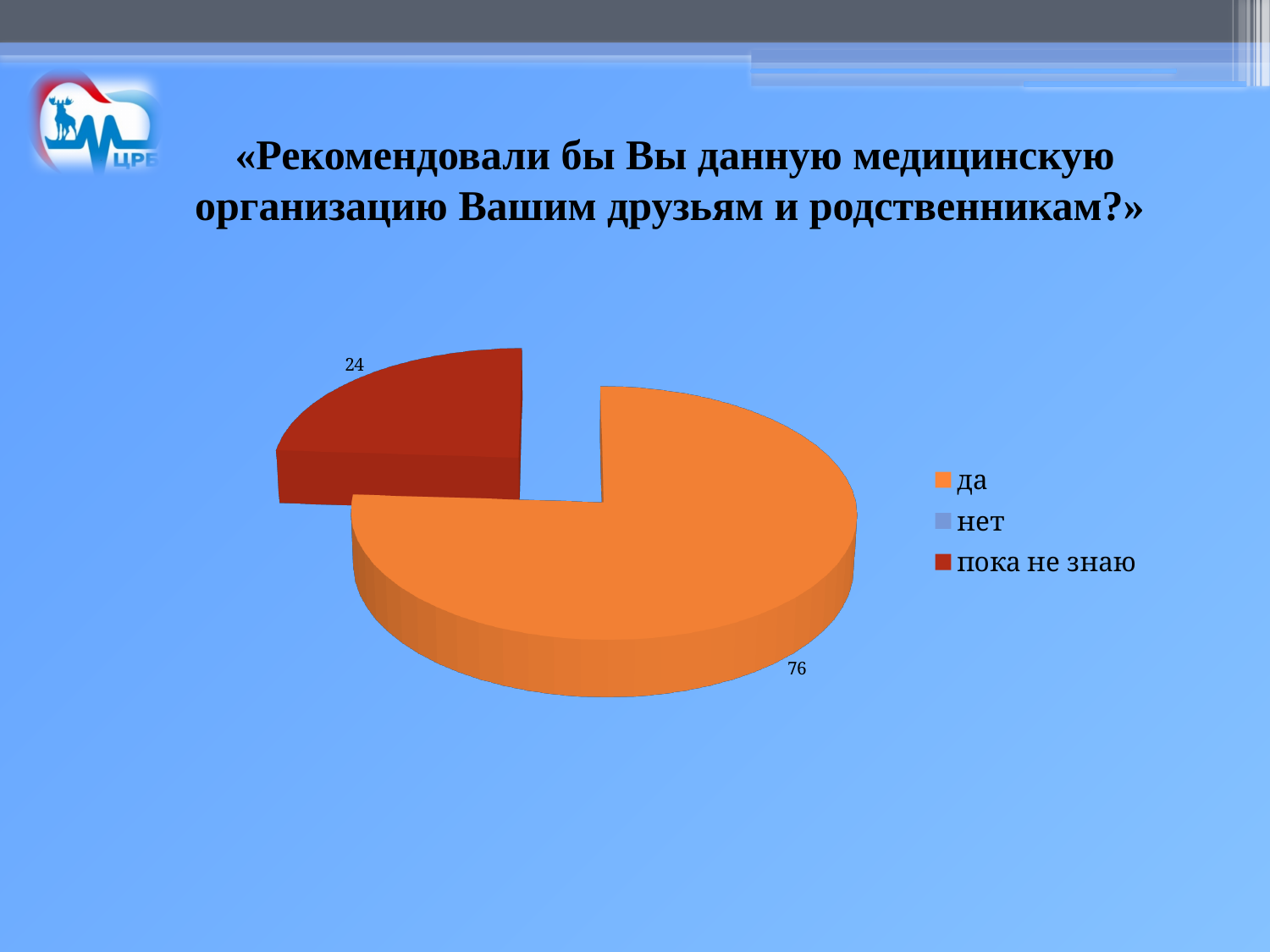
What is the value for "да"? 76 What kind of chart is shown on the slide? pie chart How many entries does the legend list? 3 What is the value for "пока не знаю"? 24 Which is larger, the value for "да" or the value for "пока не знаю"? да What colour is the slice for "да"? orange What is the total of the two labelled slice values? 100 Which of the two labelled slices is smaller, "да" or "пока не знаю"? пока не знаю What is the difference between the values for "да" and "пока не знаю"? 52 Which legend entry has no visible slice in the pie? нет Which category has the largest slice? да How many slices have a data label printed on the chart? 2